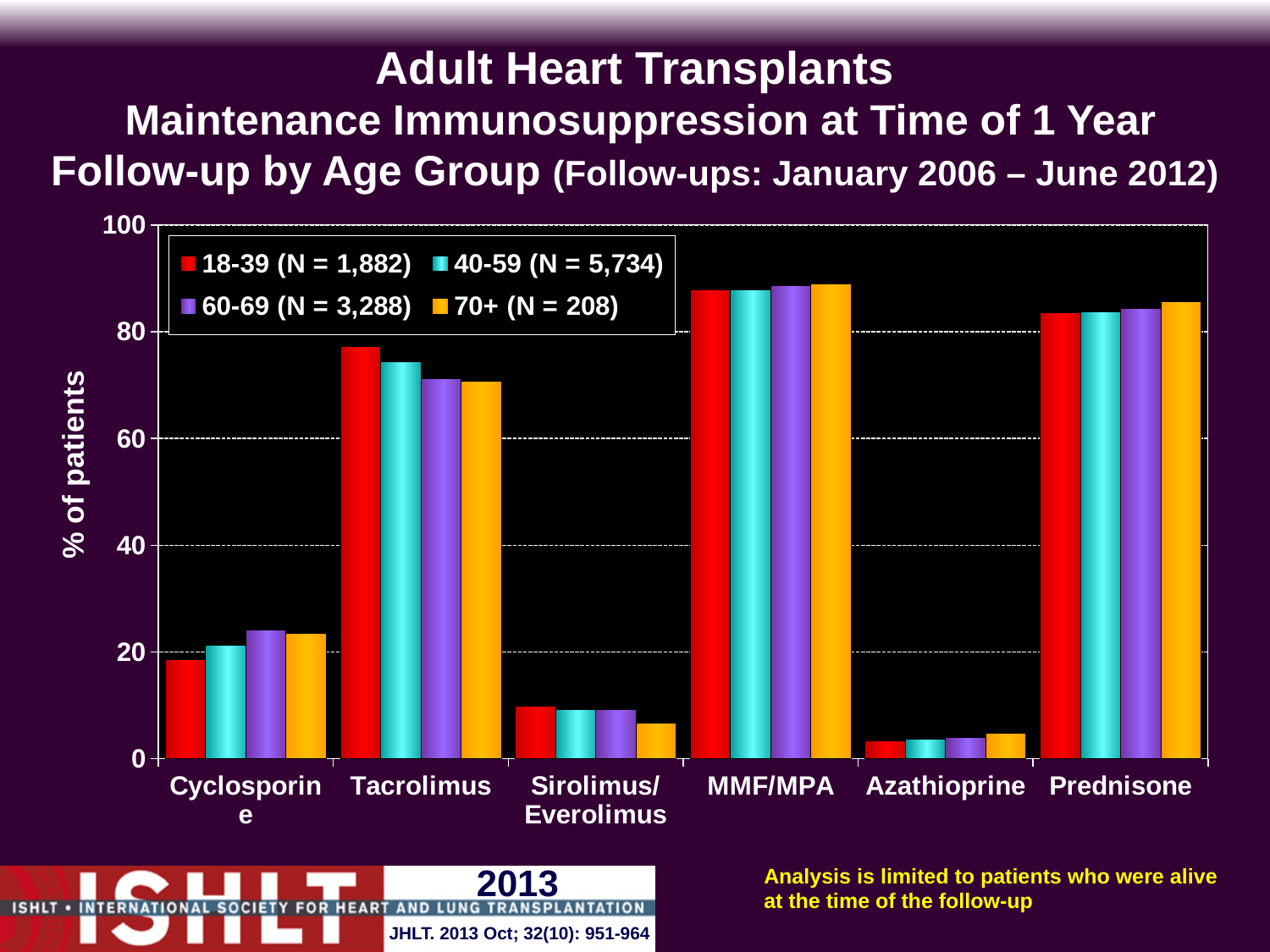
How many drug categories are shown on the x axis? 6 For Cyclosporine, which age group has the larger value: 18-39 or 60-69? 60-69 For Tacrolimus, which age group has the larger value: 18-39 or 70+? 18-39 What kind of chart is shown on the slide? bar chart Which drug has the lowest percentage of patients in the 70+ age group? Azathioprine What is the N shown in the legend for the 40-59 age group? 5,734 How many age-group series does the legend list? 4 Is the value for Sirolimus/Everolimus in the 70+ age group greater or less than 10? less Is the value for Cyclosporine in the 60-69 age group greater or less than 20? greater Is the value for MMF/MPA in the 40-59 age group greater or less than 80? greater Which drug has the highest percentage of patients in the 18-39 age group? MMF/MPA